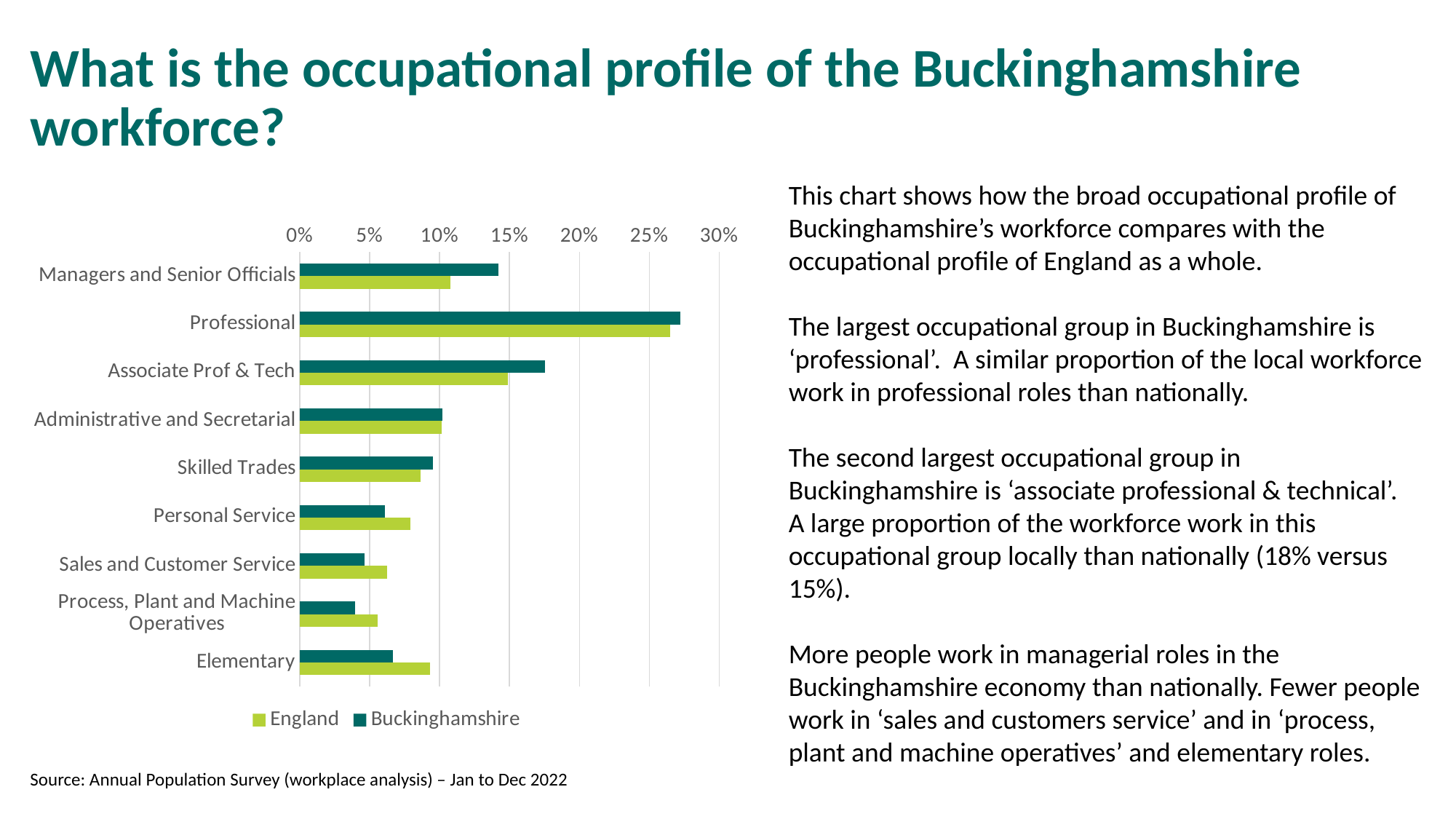
Which occupational category has the highest value for England? Professional Which series is shown in light green in the chart legend? England Which occupational category has the highest value for Buckinghamshire? Professional How many occupational categories are plotted on the chart? 9 What kind of chart is shown on the slide? Bar chart For Elementary, which is larger: the England value or the Buckinghamshire value? England How many series does the chart legend list? 2 For Associate Prof & Tech, which is larger: the England value or the Buckinghamshire value? Buckinghamshire Is the Buckinghamshire value for Managers and Senior Officials greater or less than 15%? less Is the Buckinghamshire value for Professional greater or less than 25%? greater Which occupational category has the lowest value for Buckinghamshire? Process, Plant and Machine Operatives